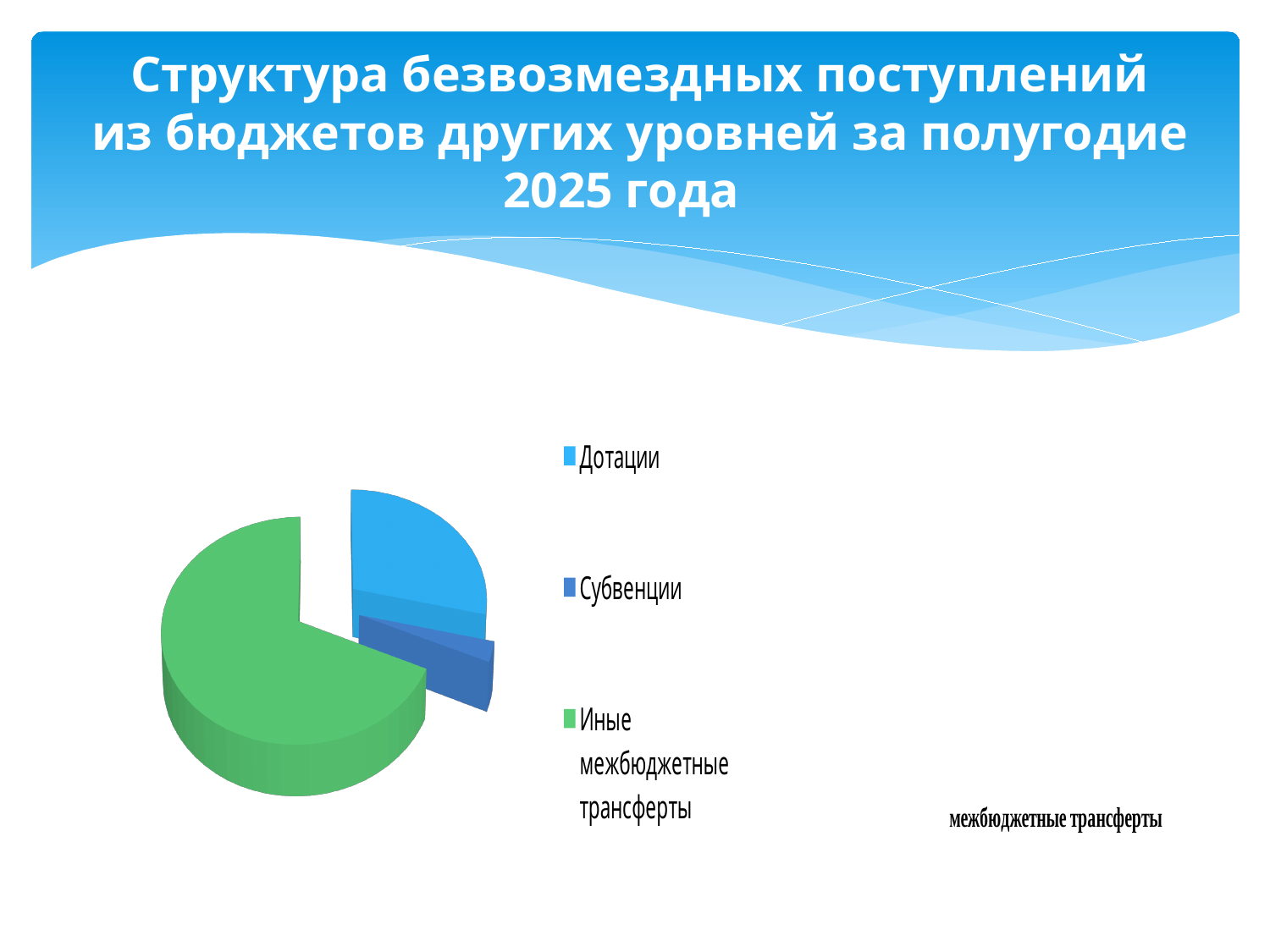
What kind of chart is shown on the slide? pie chart Which category has the largest slice of the pie chart? Иные межбюджетные трансферты Which category has the smallest slice of the pie chart? Субвенции Which slice is larger, Субвенции or Иные межбюджетные трансферты? Иные межбюджетные трансферты Which slice is larger, Дотации or Субвенции? Дотации Which slice is larger, Иные межбюджетные трансферты or Дотации? Иные межбюджетные трансферты How many slices does the pie chart have? 3 How many entries does the legend of the pie chart list? 3 What colour is the slice for Иные межбюджетные трансферты in the pie chart? green What is the title of the slide containing the pie chart? Структура безвозмездных поступлений из бюджетов других уровней за полугодие 2025 года